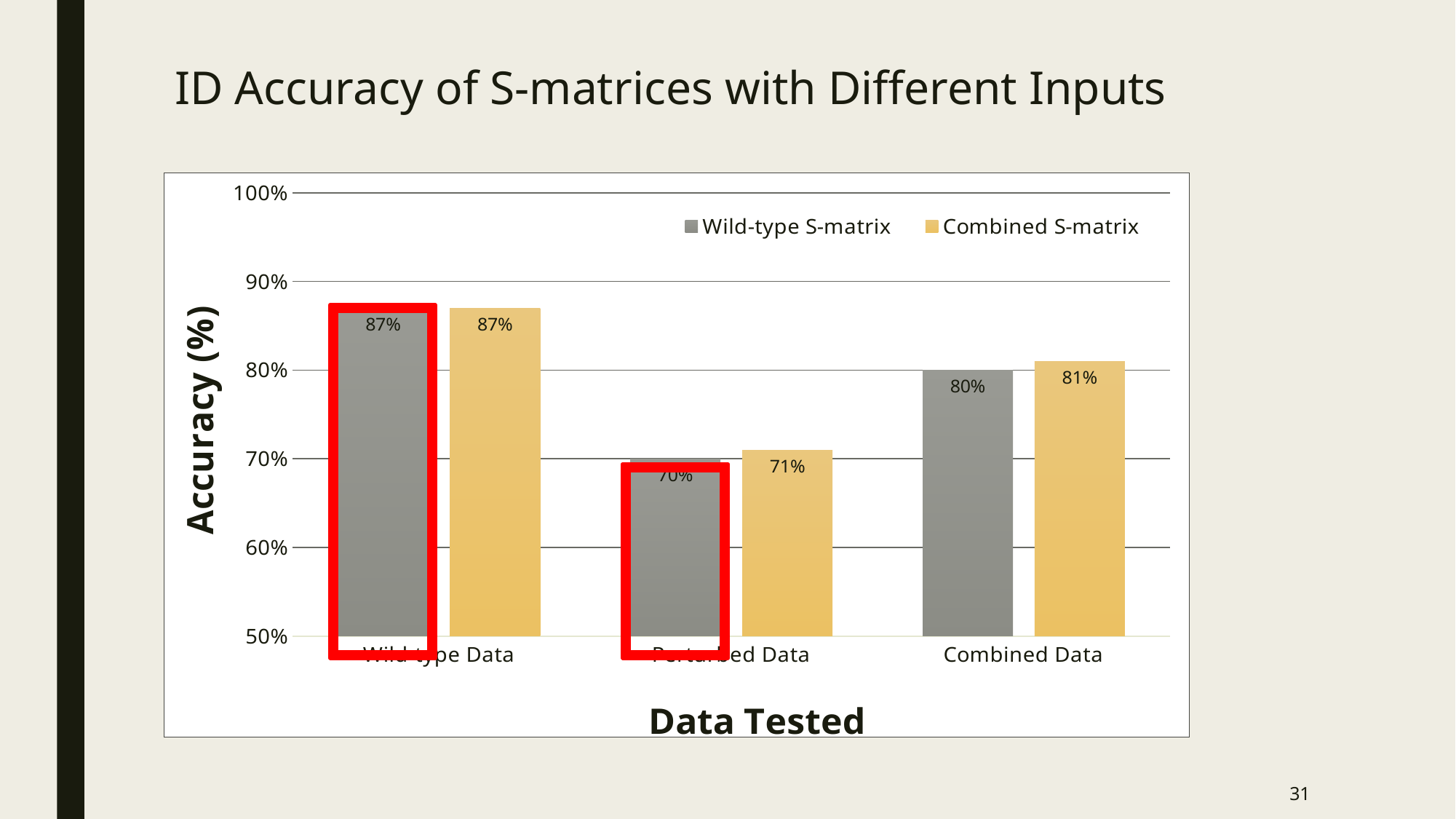
What is the label of the y axis? Accuracy (%) What is the accuracy of the Wild-type S-matrix on Wild-type Data? 87% What is the accuracy of the Combined S-matrix on Perturbed Data? 71% On which data tested does the Wild-type S-matrix have its lowest accuracy? Perturbed Data What is the difference between the Wild-type S-matrix accuracy on Wild-type Data and on Perturbed Data? 17% Which is larger on Combined Data: the Wild-type S-matrix accuracy or the Combined S-matrix accuracy? Combined S-matrix What is the accuracy of the Wild-type S-matrix on Combined Data? 80% How many series does the legend list? 2 How many data categories are shown on the x axis? 3 What is the accuracy of the Combined S-matrix on Combined Data? 81% On which data tested does the Combined S-matrix have its highest accuracy? Wild-type Data What kind of chart is shown on the slide? Bar chart